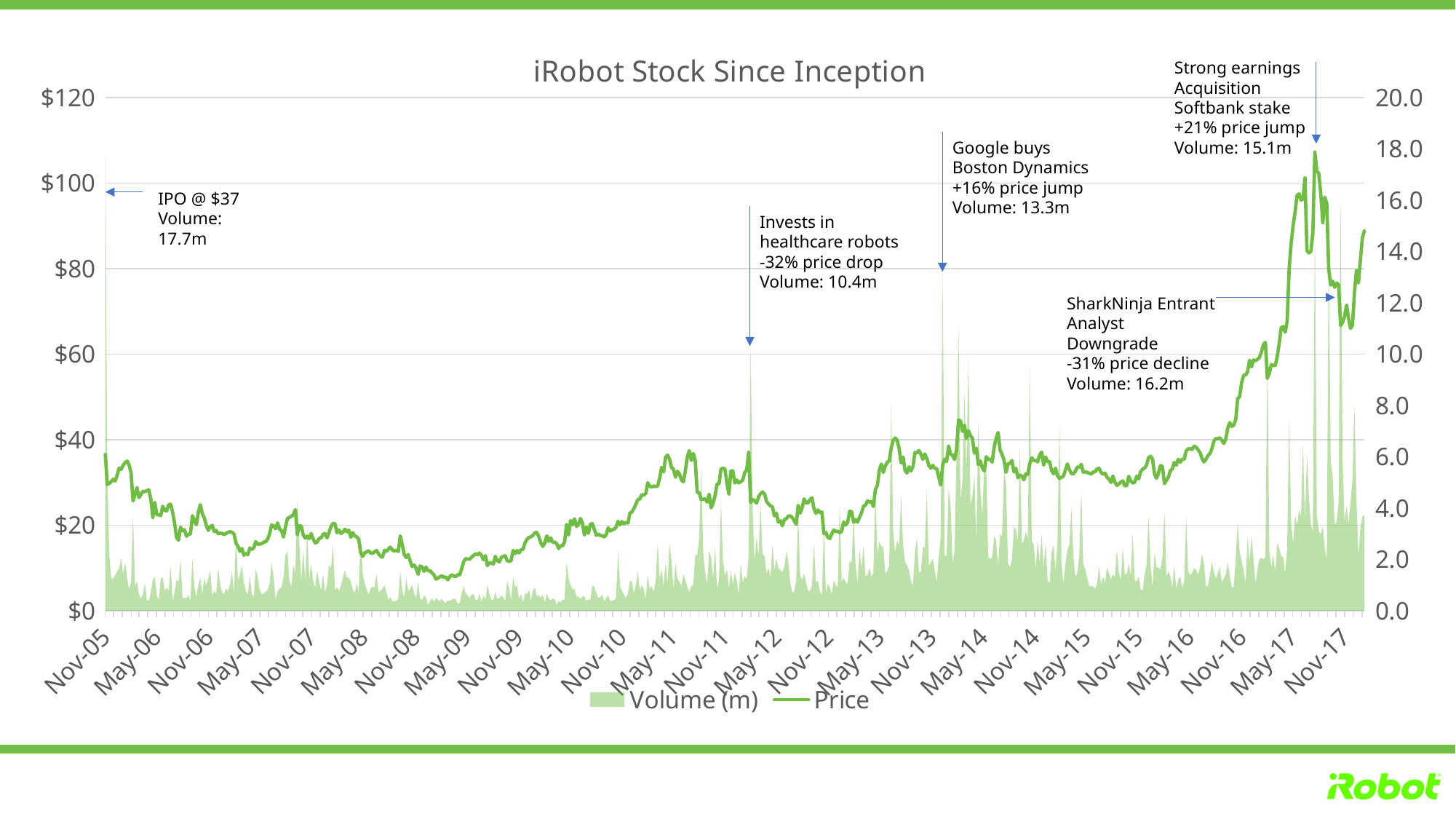
What is the difference between the volume noted for the SharkNinja Entrant event and the volume noted for the Strong earnings event? 1.1m Is the price at the end of the chart (around Nov-17) greater or less than $80? greater What is the title of the chart? iRobot Stock Since Inception What volume is noted for the IPO annotation? 17.7m How many series does the legend list? 2 What volume is noted for the 'Invests in healthcare robots' event? 10.4m Does the price generally rise or fall between May-16 and May-17? rise What are the two series named in the legend? Volume (m) and Price Which annotated event has the highest noted volume? IPO @ $37 (17.7m) Which annotated event has the lowest noted volume? Invests in healthcare robots (10.4m) What was the IPO price noted on the chart? $37 What percentage price change is noted for the 'Google buys Boston Dynamics' event? +16% price jump